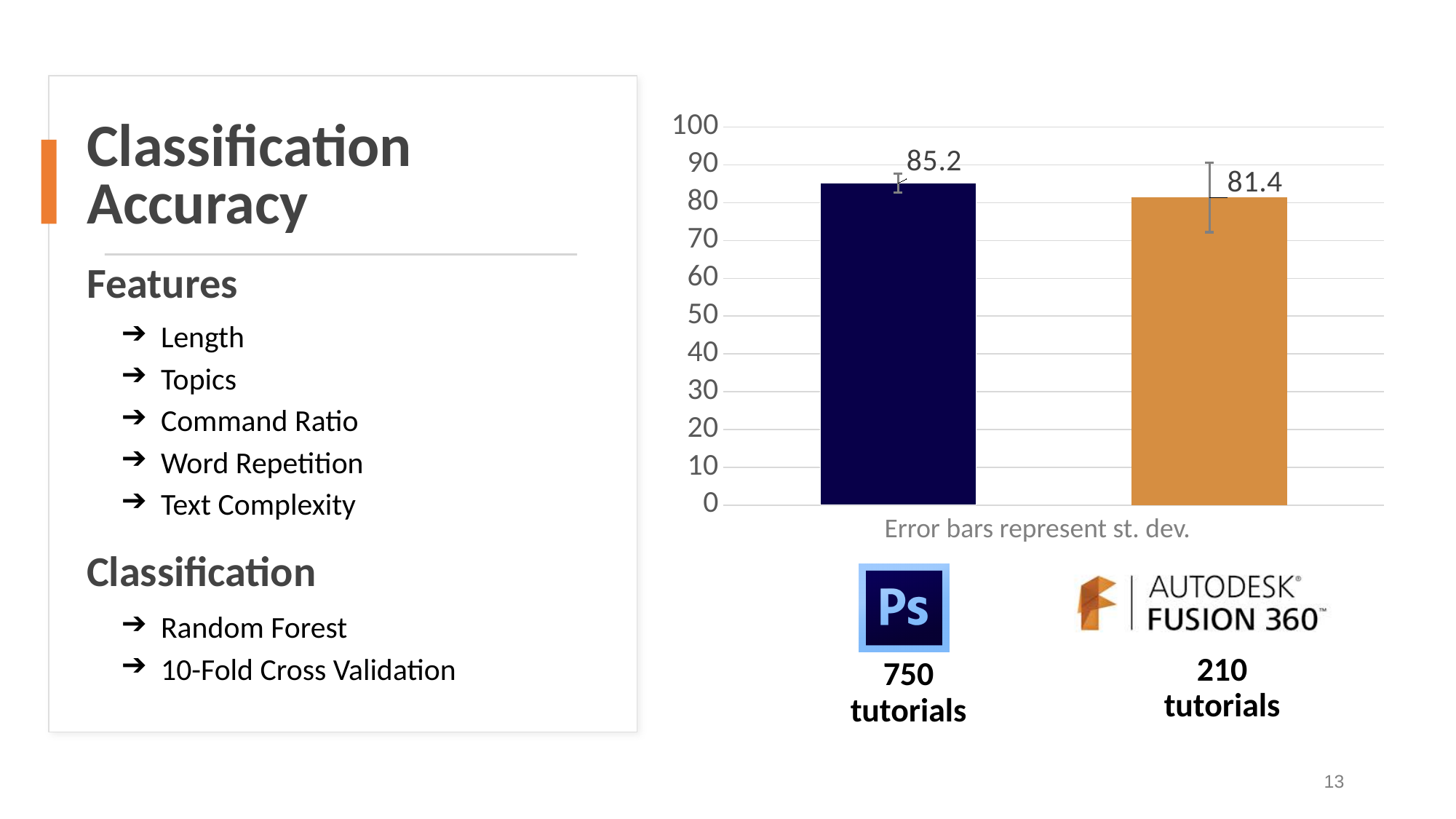
What is the maximum value shown on the vertical axis? 100 Is the value for Photoshop greater or less than 80? greater What kind of chart is shown on the slide? bar chart What is the classification accuracy for Autodesk Fusion 360 (210 tutorials)? 81.4 What is the difference between the Photoshop accuracy and the Fusion 360 accuracy? 3.8 How many bars are plotted in the chart? 2 What is the classification accuracy for Photoshop (750 tutorials)? 85.2 According to the note under the chart, what do the error bars represent? st. dev. Which bar has the lower classification accuracy, Photoshop or Fusion 360? Fusion 360 Which bar has the higher classification accuracy, Photoshop or Fusion 360? Photoshop Is the Photoshop accuracy larger or smaller than the Fusion 360 accuracy? larger Is the value for Fusion 360 greater or less than 90? less